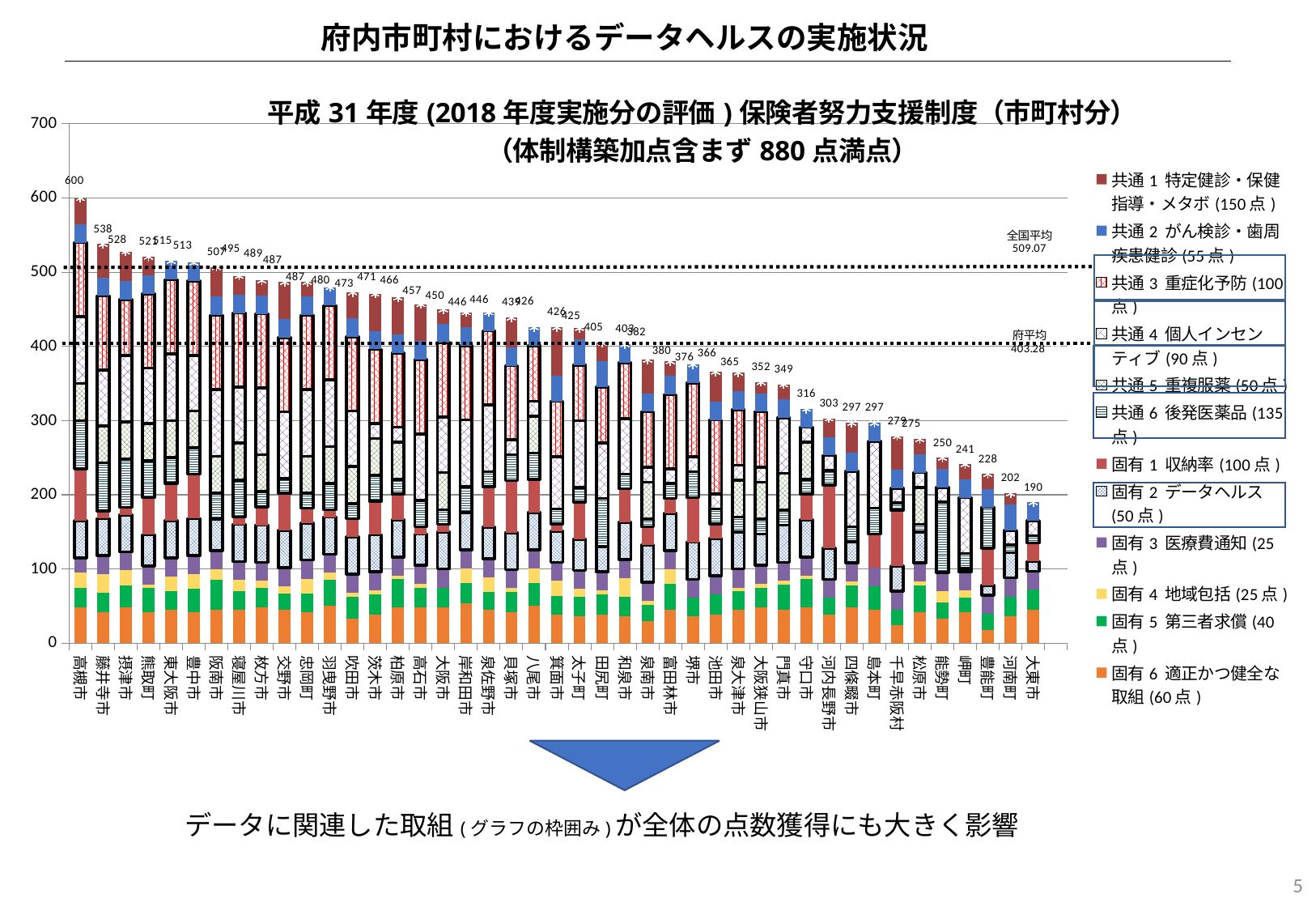
What is the difference between the total scores of 高槻市 and 大東市? 410 What kind of chart is shown on the slide? Stacked bar chart Which municipality has the lowest total score? 大東市 How many series does the legend list? 12 How many municipalities are shown on the x axis? 43 Which municipality has the highest total score? 高槻市 What is the total score labeled for 高槻市? 600 Which has a higher total score, 吹田市 or 守口市? 吹田市 What value is given for the 全国平均 (national average) reference line? 509.07 What is the total score labeled for 大阪市? 450 Do the total scores rise or fall from left to right along the x axis? Fall What is the total score labeled for 堺市? 376